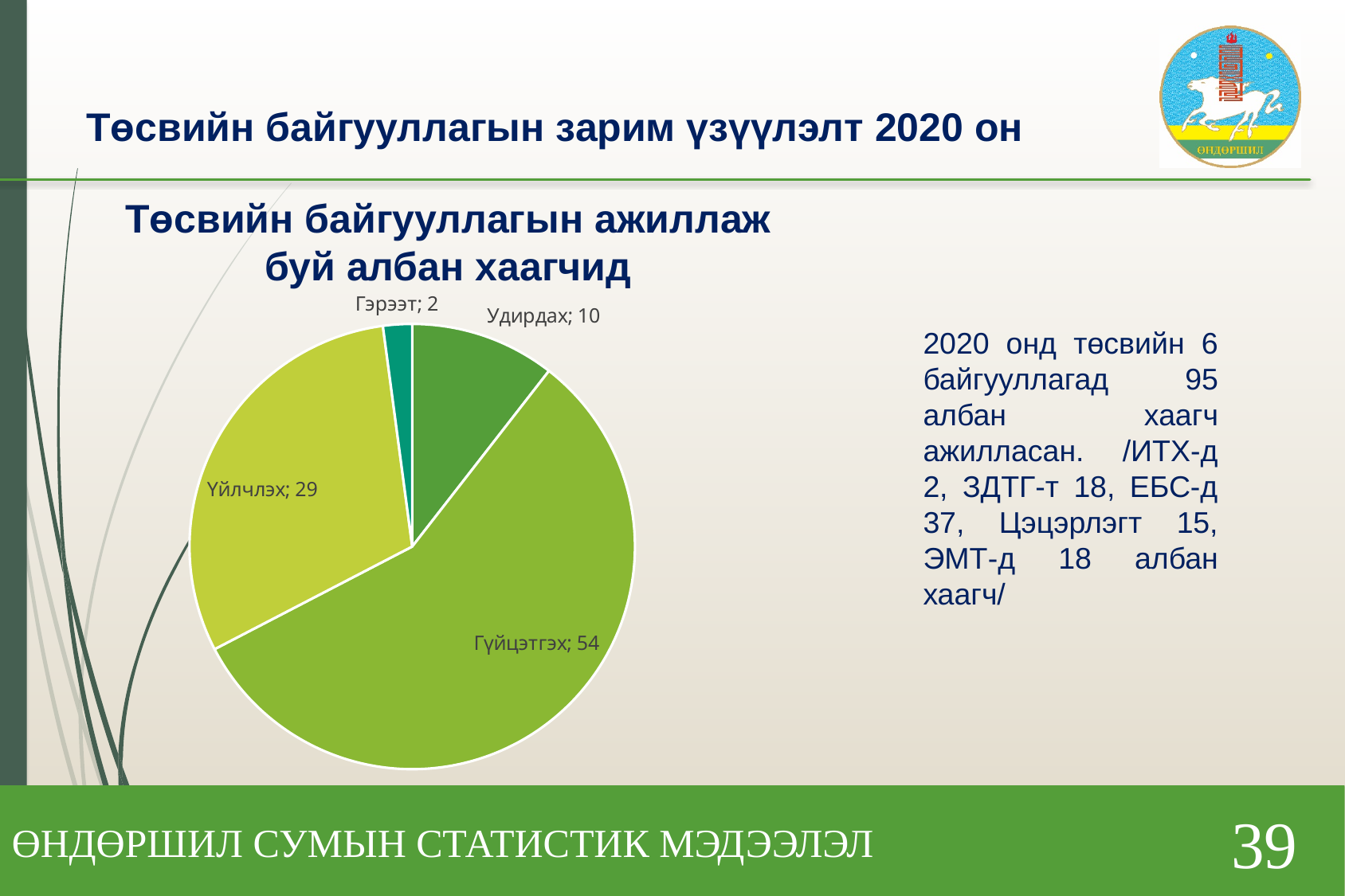
How many categories are shown in the pie chart? 4 Which category has the smallest slice in the pie chart? Гэрээт What is the difference between the values for Гүйцэтгэх and Үйлчлэх? 25 What is the title of the pie chart? Төсвийн байгууллагын ажиллаж буй албан хаагчид What type of chart is shown on the slide? Pie chart What is the value for Үйлчлэх in the pie chart? 29 What is the value for Удирдах in the pie chart? 10 Which category has the largest slice in the pie chart? Гүйцэтгэх Which is larger, the value for Удирдах or the value for Үйлчлэх? Үйлчлэх What is the value for Гэрээт in the pie chart? 2 What is the value for Гүйцэтгэх in the pie chart? 54 What is the total of all slices in the pie chart? 95